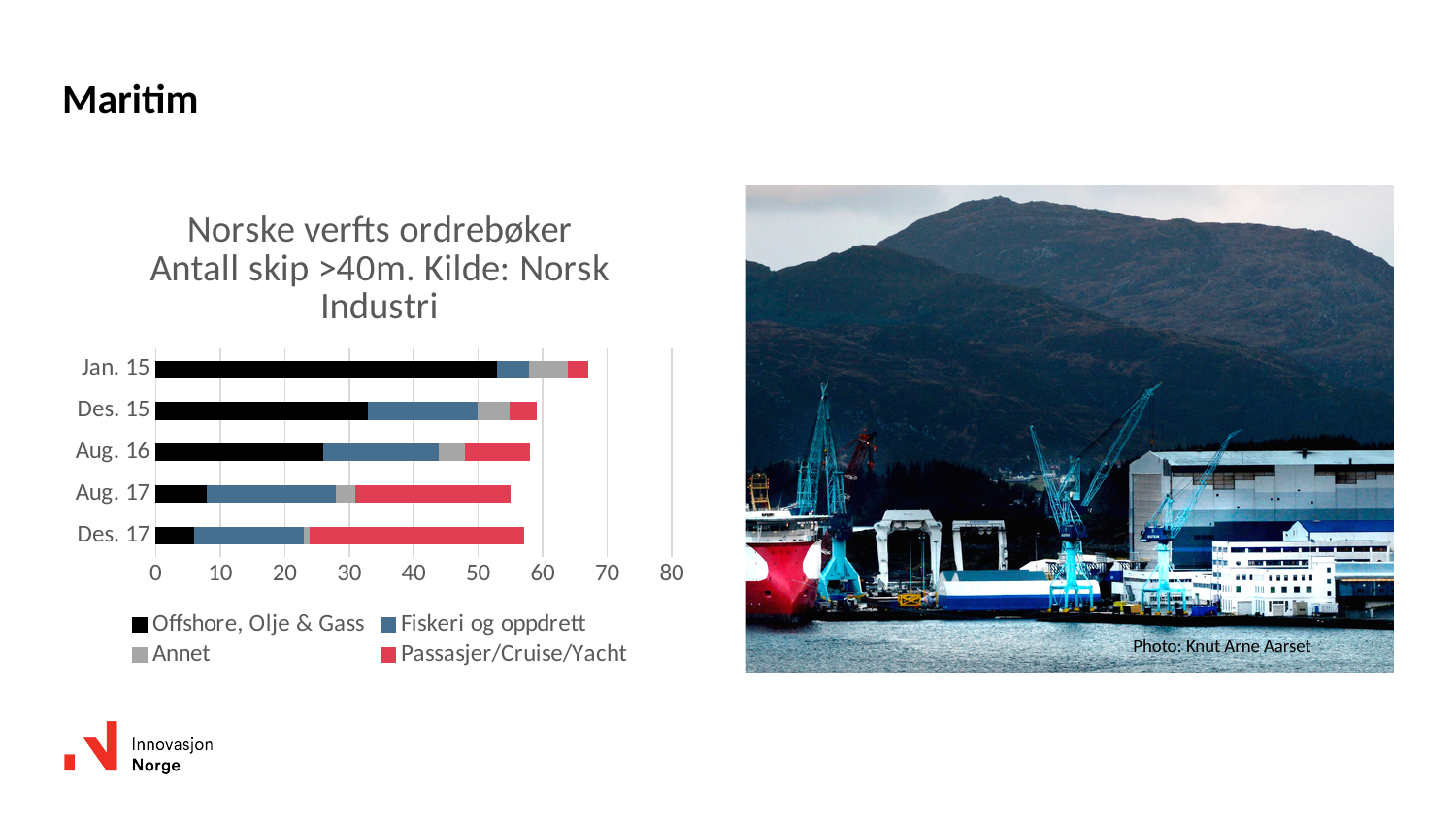
Which category has the largest Offshore, Olje & Gass segment? Jan. 15 Which series is shown in red in the chart legend? Passasjer/Cruise/Yacht Which category has the longest total bar? Jan. 15 How many series does the chart legend list? 4 Is the Offshore, Olje & Gass value for Jan. 15 greater or less than 40? greater Is the total bar for Jan. 15 greater or less than 60? greater Which category has the smallest Passasjer/Cruise/Yacht segment? Jan. 15 Does the Offshore, Olje & Gass segment rise or fall from Jan. 15 to Des. 17? fall How many time periods (categories) are shown on the chart? 5 Which category has the largest Passasjer/Cruise/Yacht segment? Des. 17 Is the Offshore, Olje & Gass value for Des. 17 greater or less than 10? less What kind of chart is shown on the slide? Stacked bar chart